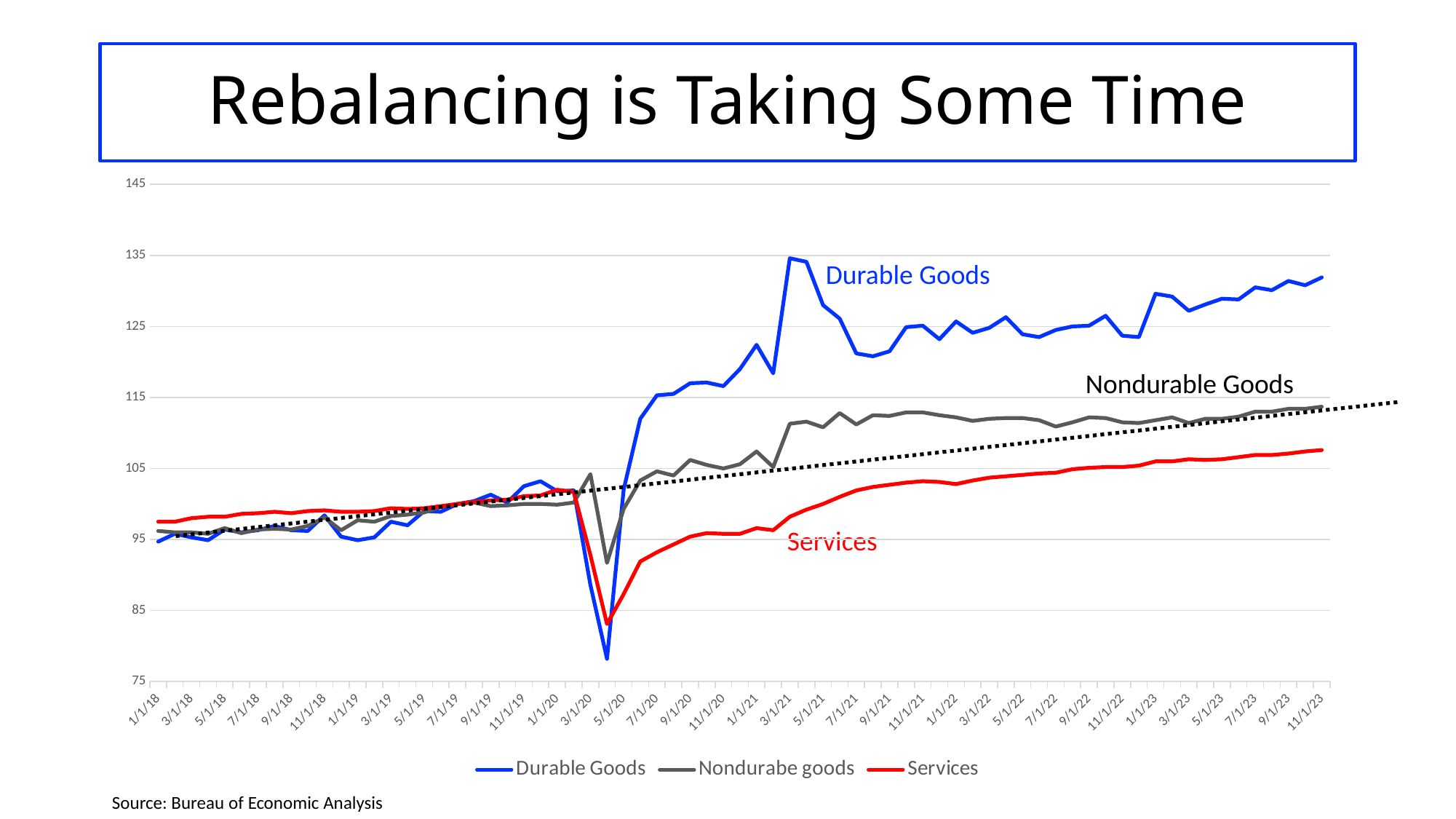
Is the value for Services at 11/1/23 greater or less than 105? greater Which series has the lowest value at 11/1/23? Services Does the Services line rise or fall from 5/1/20 to 11/1/23? Rises What is the title of the slide? Rebalancing is Taking Some Time Is the value for Durable Goods at 11/1/23 greater or less than 125? greater Is the value for Nondurable goods at 11/1/23 greater or less than 105? greater What kind of chart is shown on the slide? Line chart Which series has the highest value at 11/1/23? Durable Goods What colour is the Services line? Red How many series does the legend list? 3